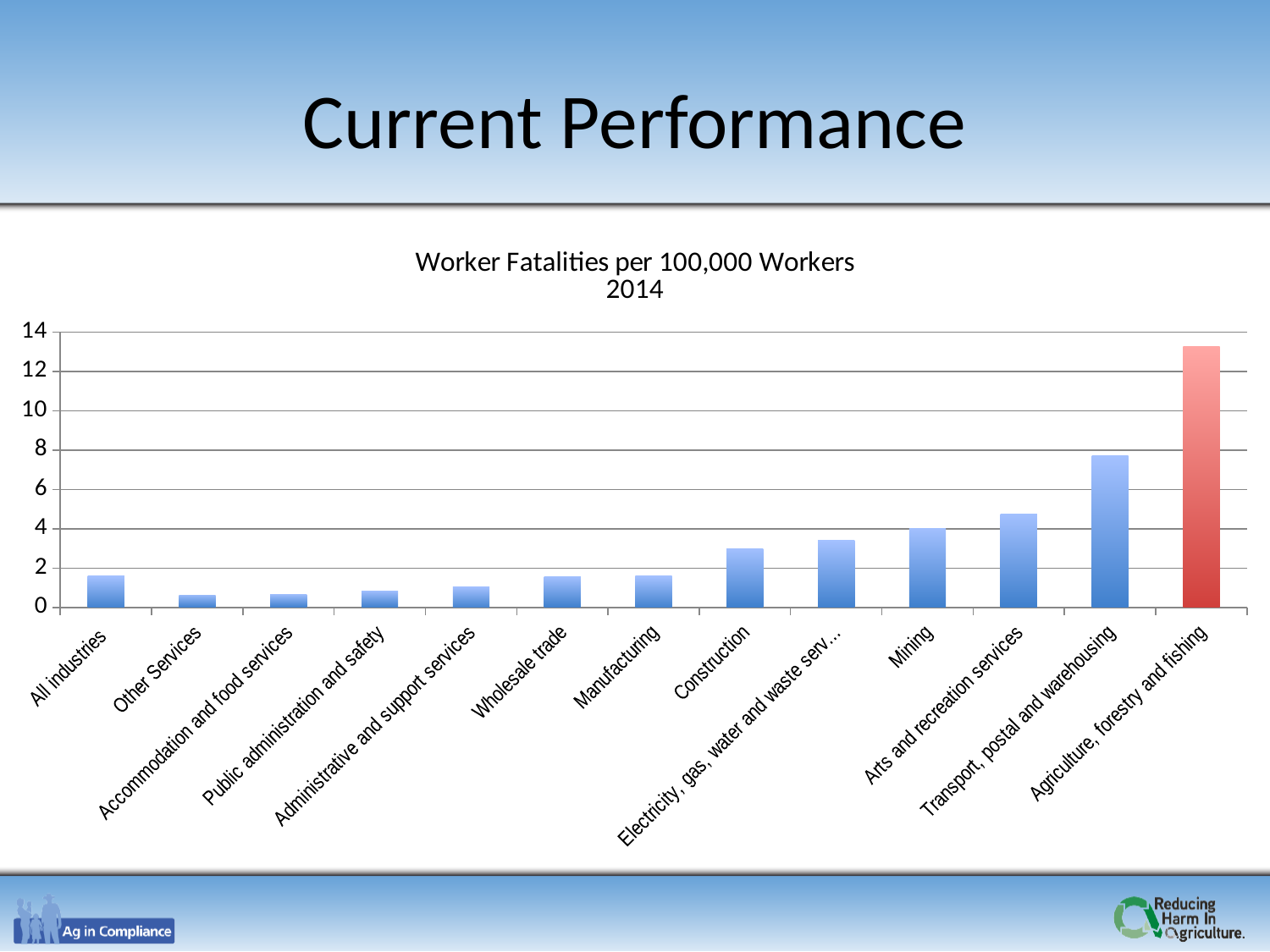
Is the value for Other Services greater or less than 2? less Is the value for Construction greater or less than 2? greater Which has a higher fatality rate, Mining or Construction? Mining Which has a higher fatality rate, Transport, postal and warehousing or Arts and recreation services? Transport, postal and warehousing Which industry has the highest worker fatality rate? Agriculture, forestry and fishing Is the value for Agriculture, forestry and fishing greater or less than 12? greater Do the values generally rise or fall moving from left to right across the categories? rise What kind of chart is shown on the slide? bar chart What colour is the bar for Agriculture, forestry and fishing? red How many industry categories are plotted on the chart? 13 What is the title of the chart? Worker Fatalities per 100,000 Workers 2014